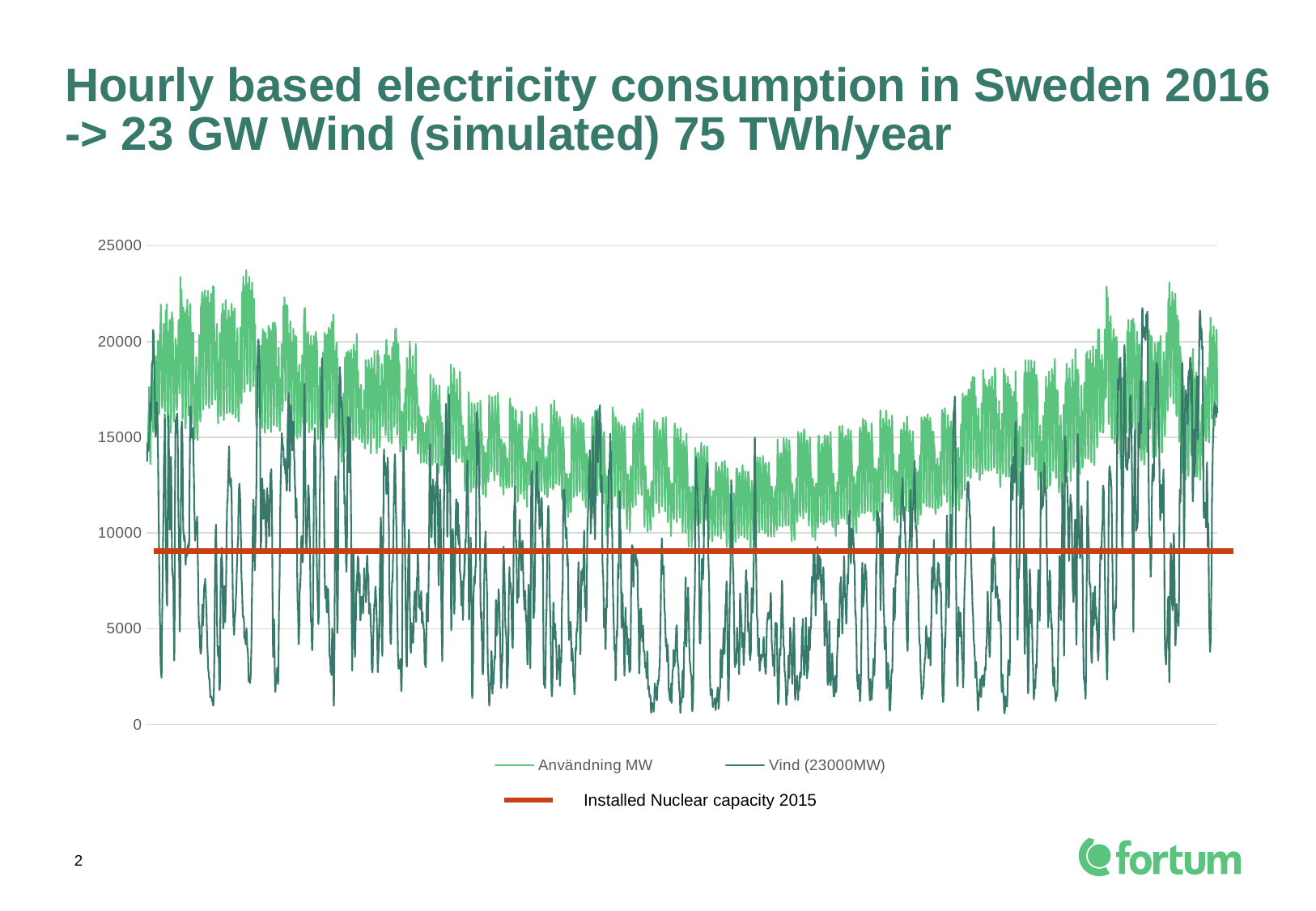
Is the highest value of the Användning MW series greater or less than 20000? greater Is the lowest value of the Användning MW series greater or less than 5000? greater What is the highest value shown on the vertical axis? 25000 Does the Användning MW series rise or fall from the middle of the x axis to the end of the x axis? rise Does the Användning MW series rise or fall from the start of the x axis to the middle of the x axis? fall Is the Installed Nuclear capacity 2015 line greater or less than 5000? greater Which series is generally higher across the chart, Användning MW or Vind (23000MW)? Användning MW What does the red horizontal line on the chart represent? Installed Nuclear capacity 2015 What kind of chart is shown on the slide? line chart